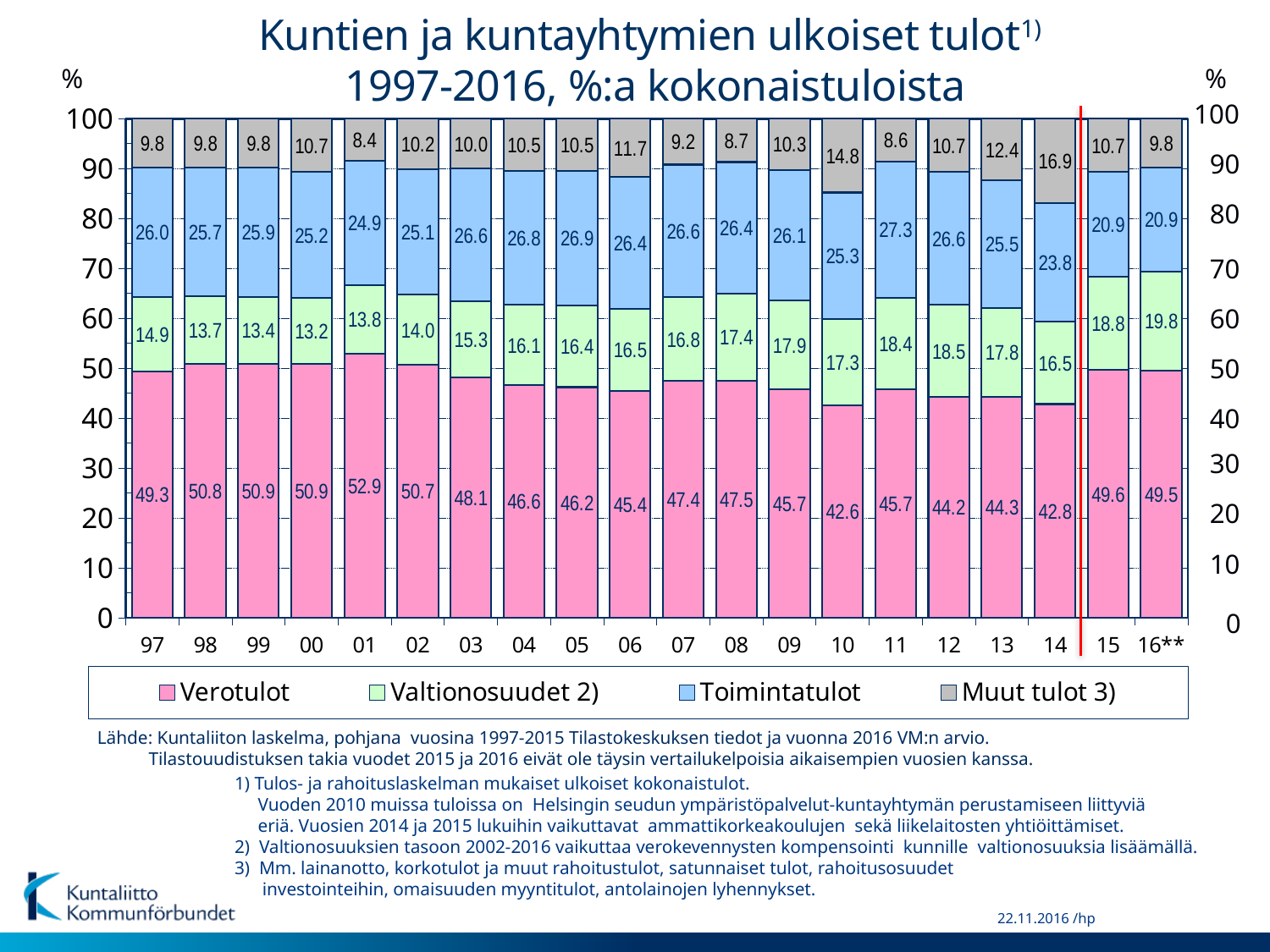
What is the Toimintatulot value for 2011 (11)? 27.3 In which year is the Verotulot share lowest? 10 How many years are shown on the x axis? 20 What is the difference between the Verotulot value in 2001 (01) and in 2010 (10)? 10.3 In which year is the Verotulot share highest? 01 What is the Verotulot value for 2001 (01)? 52.9 What is the Muut tulot 3) value for 2014 (14)? 16.9 Which is larger, the Valtionosuudet 2) value in 1997 (97) or in 2016 (16**)? 2016 (16**) How many series does the legend list? 4 In which year is the Muut tulot 3) share highest? 14 What is the Valtionosuudet 2) value for 2016 (16**)? 19.8 What kind of chart is shown on the slide? Stacked bar chart